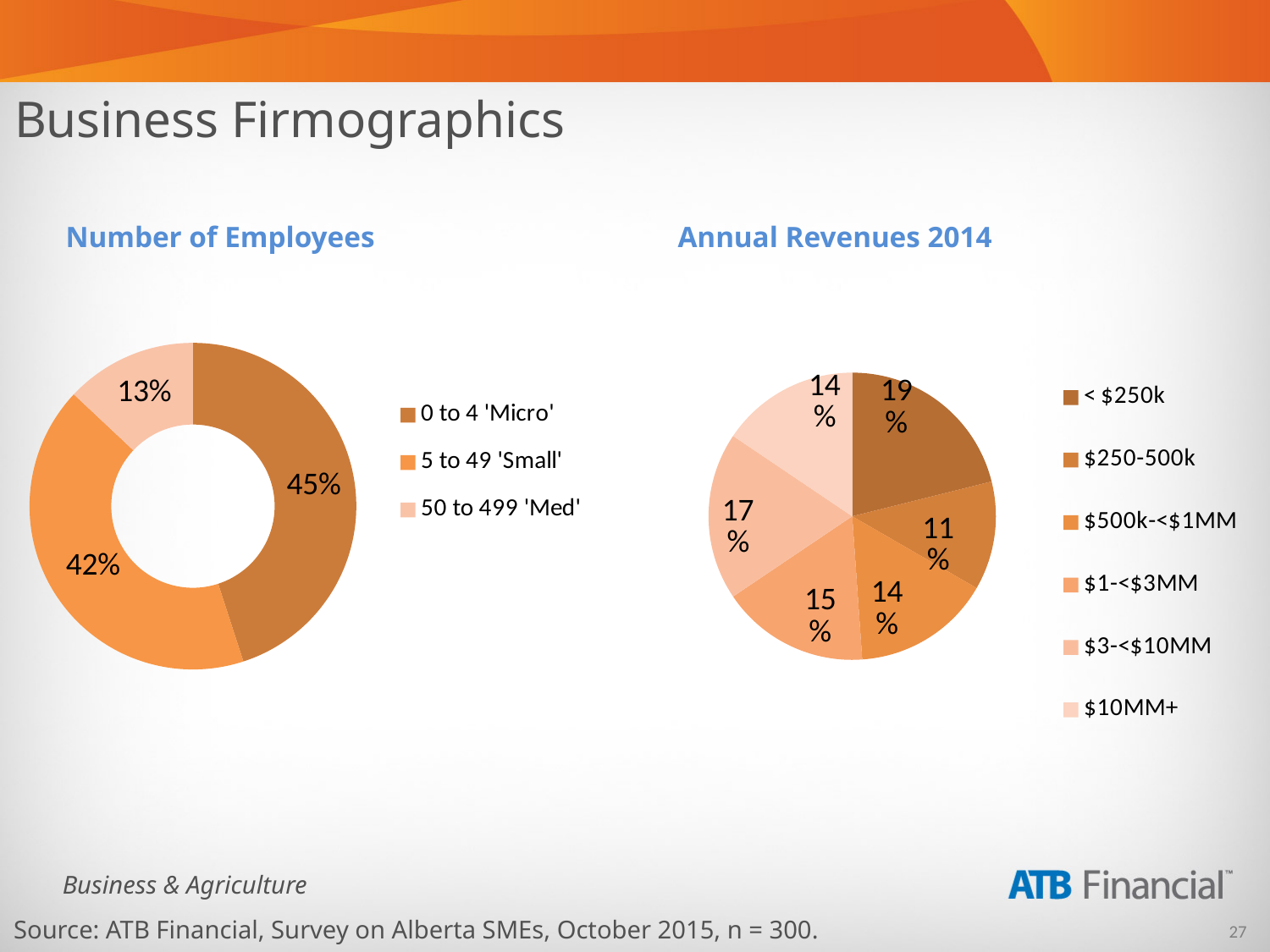
In the Number of Employees chart, what share of businesses have 50 to 499 'Med' employees? 13% In the Number of Employees chart, which category has the largest share? 0 to 4 'Micro' What kind of chart is the Annual Revenues 2014 chart? Pie chart In the Annual Revenues 2014 chart, which revenue category has the smallest share? $250-500k In the Annual Revenues 2014 chart, which is larger: the share for $1-<$3MM or the share for $250-500k? $1-<$3MM In the Annual Revenues 2014 chart, how many revenue categories does the legend list? 6 In the Number of Employees chart, what share of businesses have 0 to 4 'Micro' employees? 45% In the Number of Employees chart, what is the difference between the 5 to 49 'Small' share and the 50 to 499 'Med' share? 29% What kind of chart is the Number of Employees chart? Doughnut chart In the Annual Revenues 2014 chart, what share of businesses have revenues of $3-<$10MM? 17% In the Annual Revenues 2014 chart, what share of businesses have revenues under $250k? 19% In the Number of Employees chart, how many categories are shown? 3